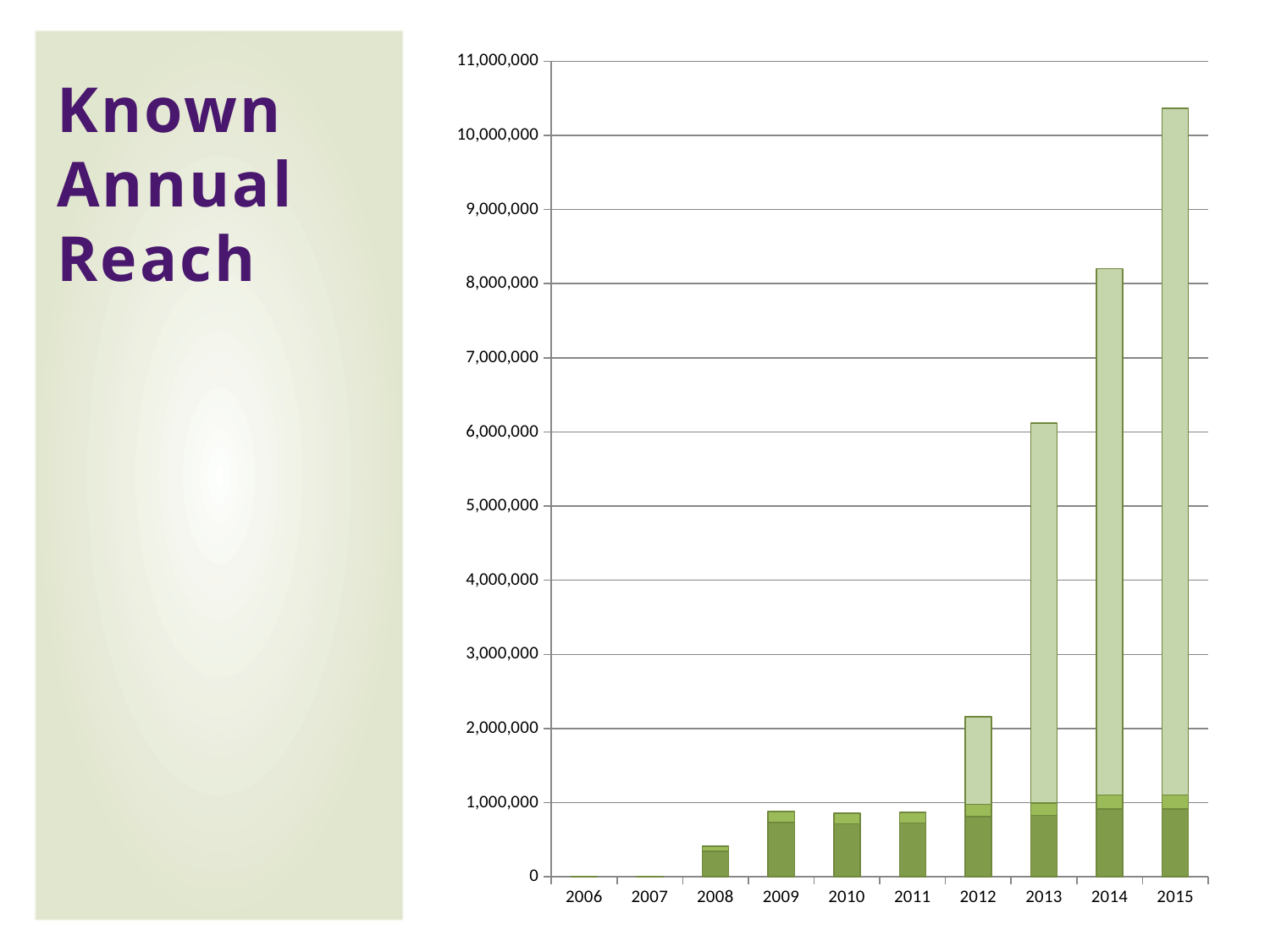
Which year has the larger total bar, 2012 or 2013? 2013 Is the total value for 2014 greater or less than 9,000,000? less What is the title shown on the slide next to the chart? Known Annual Reach Is the total value for 2009 greater or less than 1,000,000? less Is the total value for 2013 greater or less than 7,000,000? less How many years are shown on the x axis of the chart? 10 Do the total bar values generally rise or fall from 2006 to 2015? rise Which year has the highest total bar in the chart? 2015 Which year has the larger total bar, 2014 or 2015? 2015 What kind of chart is shown on the slide? bar chart